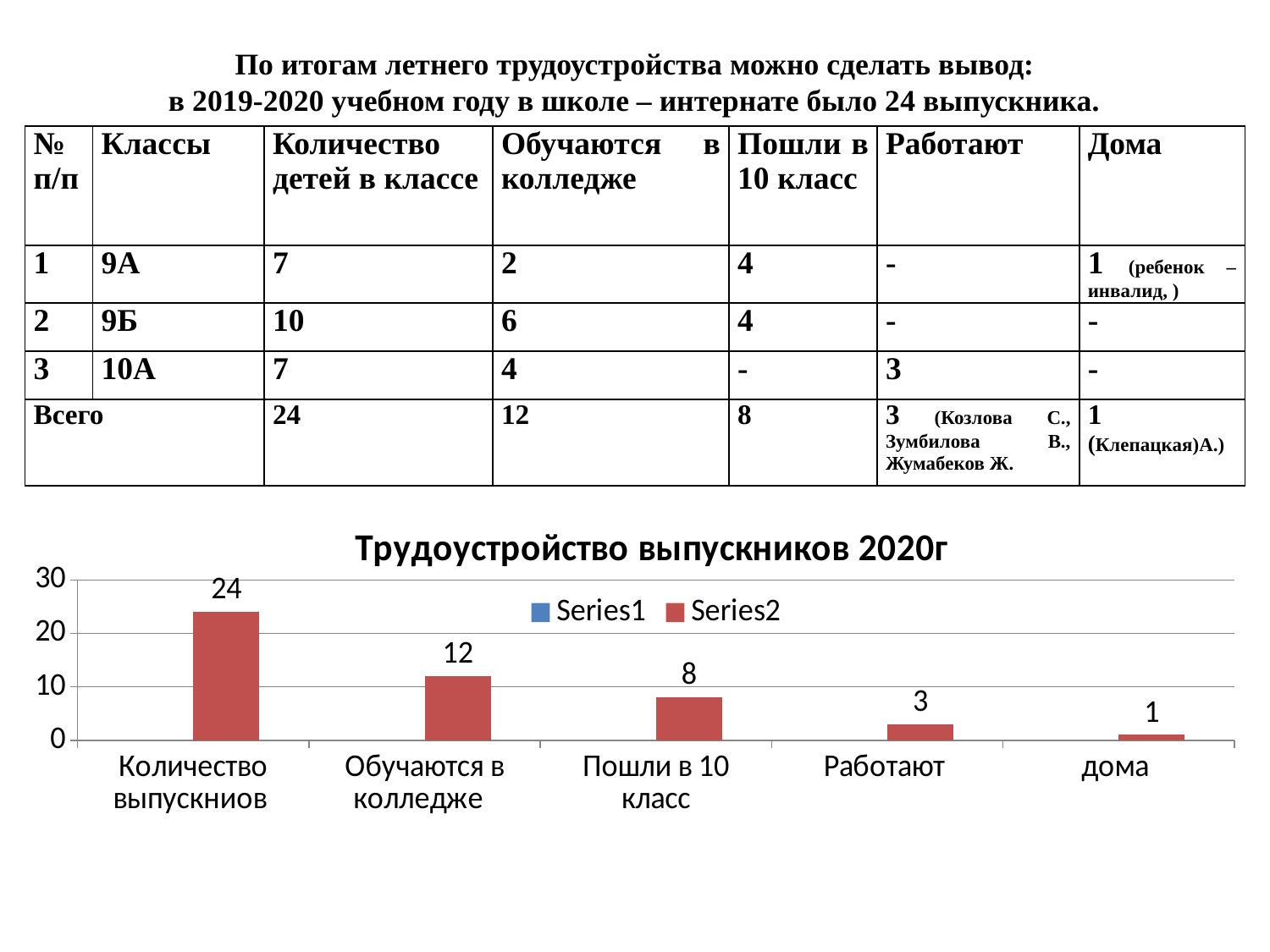
What is the title of the chart? Трудоустройство выпускников 2020г What is the value for "Обучаются в колледже" in the chart? 12 Which is larger: the value for "Пошли в 10 класс" or the value for "Работают"? Пошли в 10 класс Which category has the lowest value in the chart? дома Is the value for "Обучаются в колледже" greater or less than 10? greater What is the value for "Пошли в 10 класс" in the chart? 8 What is the value for "Работают" in the chart? 3 What is the difference between the values for "Количество выпускниов" and "Обучаются в колледже"? 12 How many categories are shown on the x axis of the chart? 5 How many series does the chart legend list? 2 Which category has the highest value in the chart? Количество выпускниов What is the value for "дома" in the chart? 1